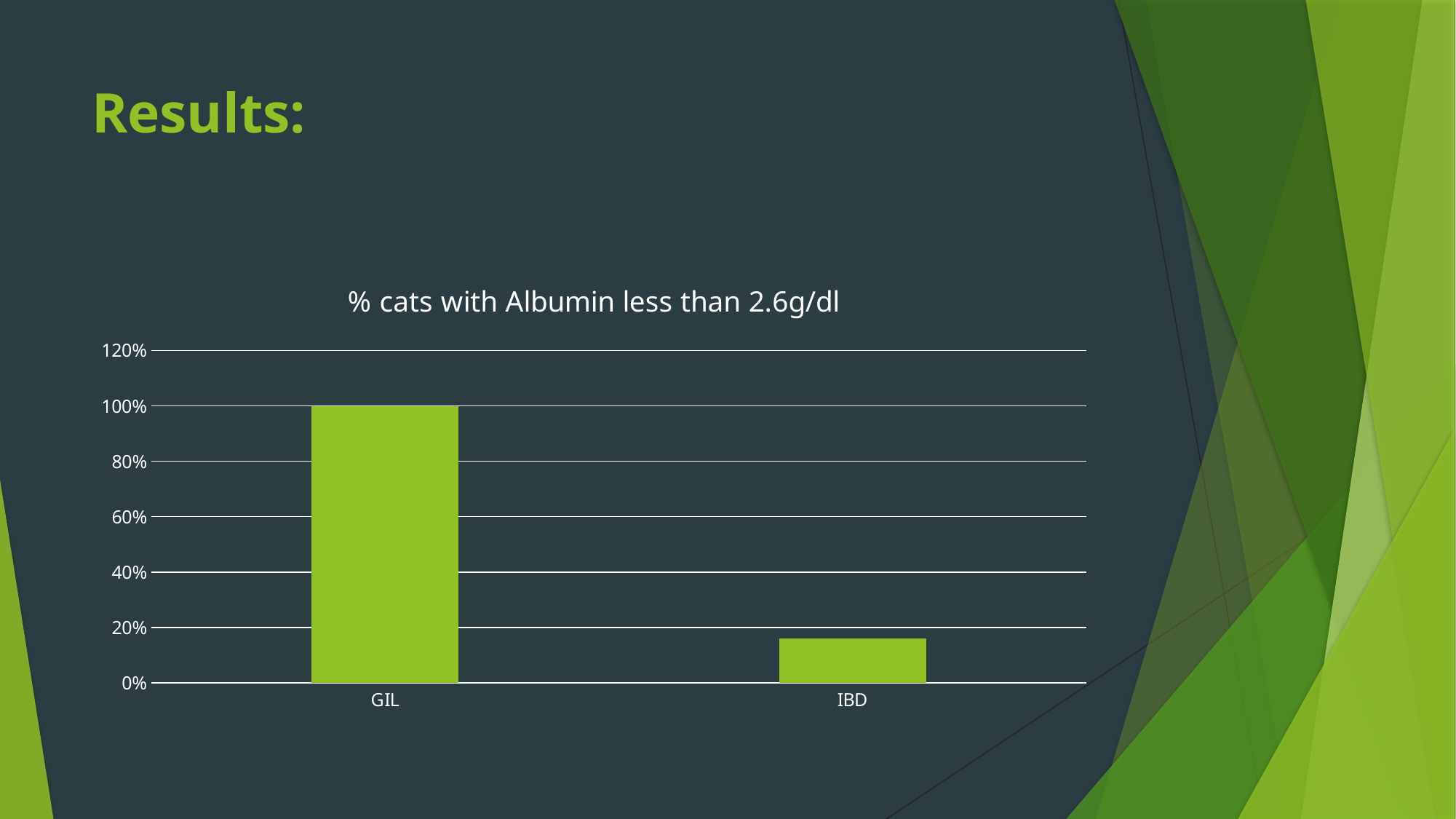
Is the value for IBD greater or less than 40%? less Which is larger, the value for GIL or the value for IBD? GIL How many categories are plotted on the x axis? 2 What kind of chart is shown on the slide? bar chart What is the title of the chart? % cats with Albumin less than 2.6g/dl What is the highest value labelled on the vertical axis? 120% What is the value for GIL? 100% Is the value for IBD greater or less than 20%? less Which category has the highest value? GIL Do the values rise or fall moving from GIL to IBD along the x axis? fall Which category has the lowest value? IBD